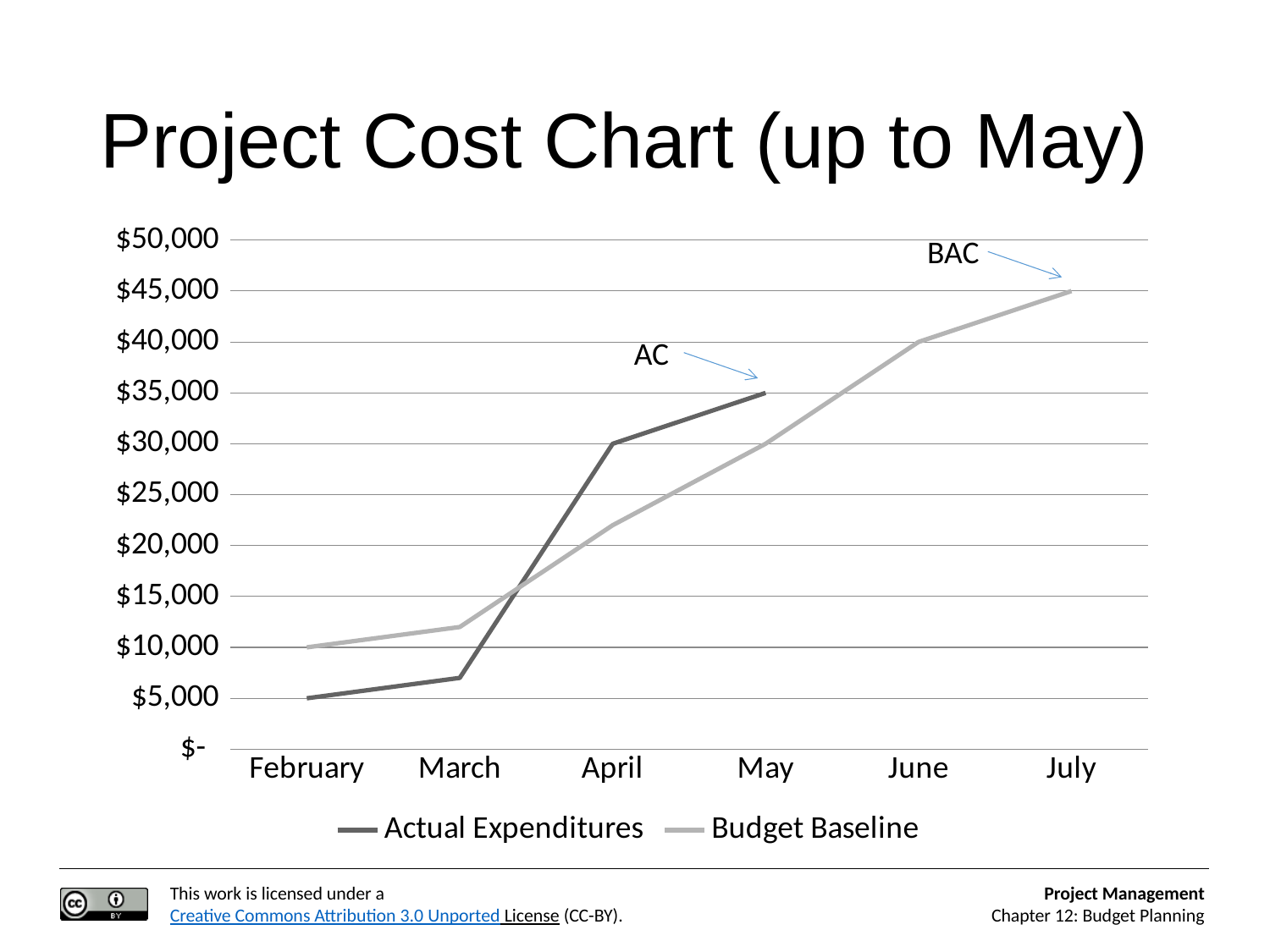
How many series does the legend list? 2 What is the value of the Budget Baseline in June? $40,000 What is the value of the Budget Baseline in July? $45,000 How many months are shown on the x axis? 6 By how much did Actual Expenditures increase from April to May? $5,000 What is the value of Actual Expenditures in May? $35,000 Is the Budget Baseline value for March greater or less than $15,000? less What label is attached to the end of the Budget Baseline line in July? BAC Does the Budget Baseline rise or fall from February to July? rise What is the value of Actual Expenditures in February? $5,000 What kind of chart is shown on the slide? line chart In April, which series is higher, Actual Expenditures or Budget Baseline? Actual Expenditures